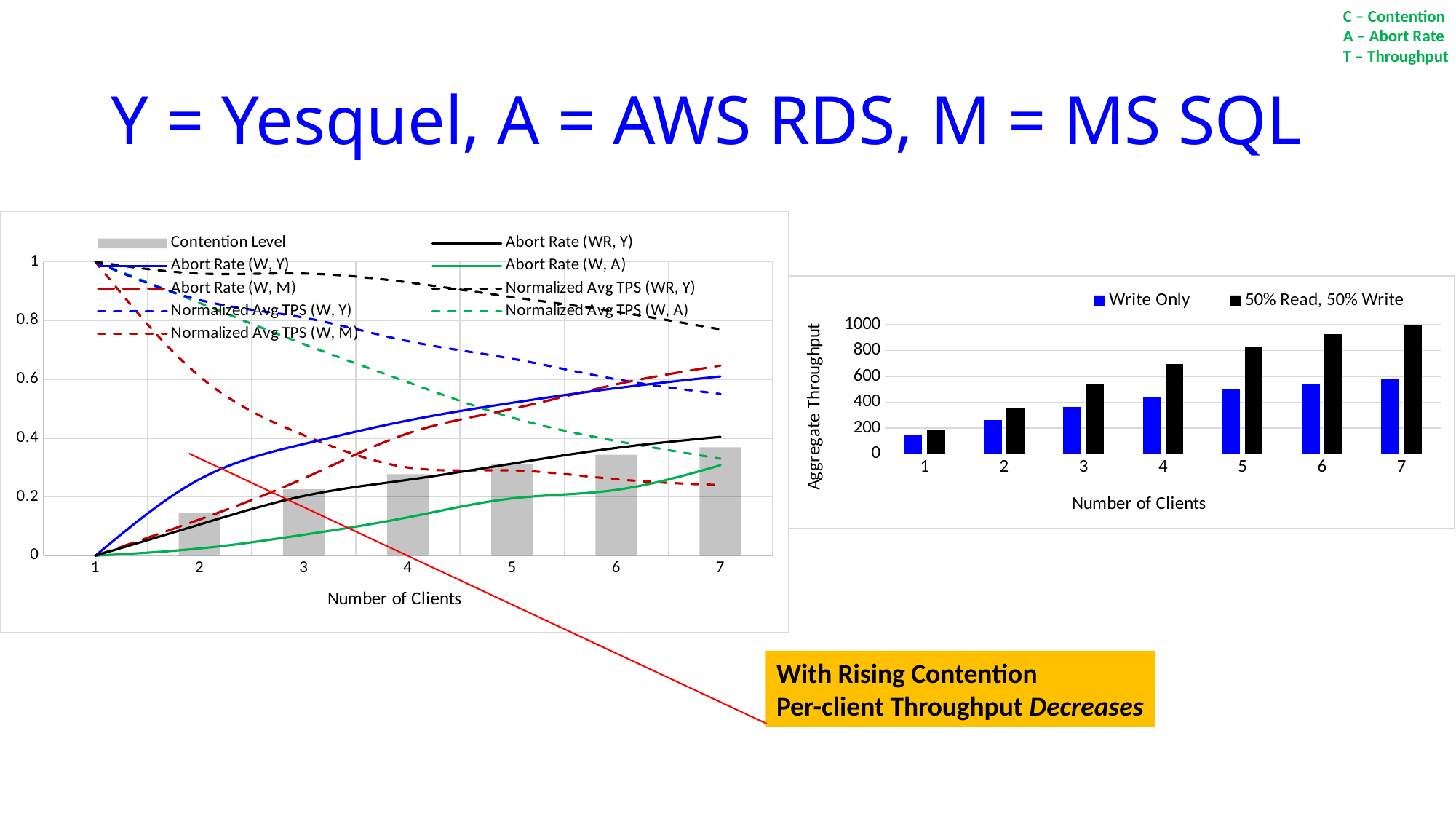
In the chart on the right, how many Number of Clients categories are shown on the x axis? 7 In the chart on the left, does Normalized Avg TPS (W, M) rise or fall as the number of clients increases? falls In the chart on the right, at which number of clients is the Write Only bar highest? 7 In the chart on the right, how many series does the legend list? 2 In the chart on the right, is the Write Only value at 3 clients greater or less than 400? less What kind of chart is the chart on the right of the slide? bar chart In the chart on the left, is the Contention Level bar at 7 clients greater or less than 0.2? greater In the chart on the left, which is larger at 7 clients: Abort Rate (W, Y) or Abort Rate (W, A)? Abort Rate (W, Y) In the chart on the right, is the 50% Read, 50% Write value at 6 clients greater or less than 800? greater In the chart on the right, does the 50% Read, 50% Write throughput rise or fall as the number of clients increases? rises In the chart on the right, which series has the taller bar at 7 clients? 50% Read, 50% Write In the chart on the left, how many series does the legend list? 9